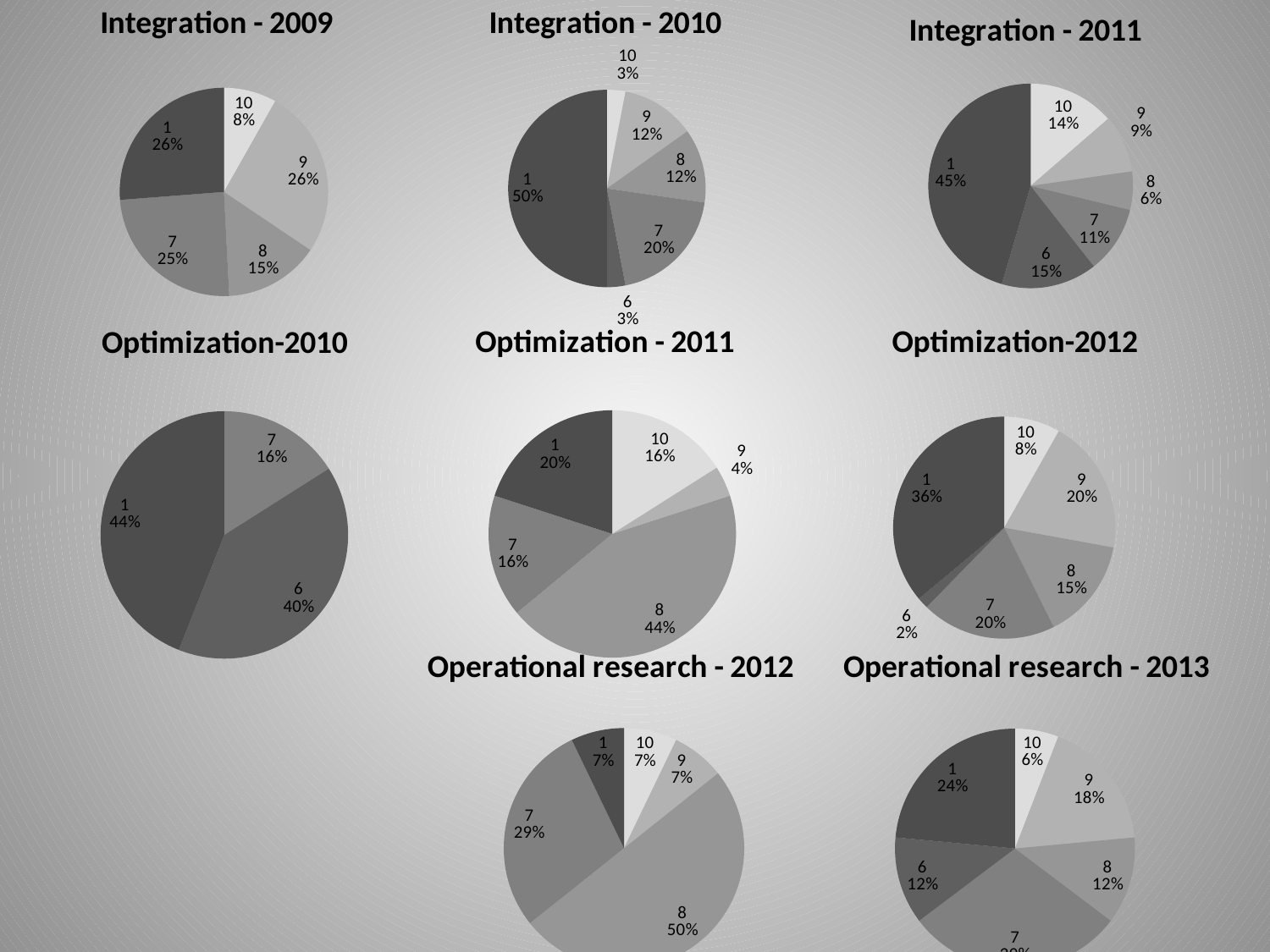
How many slices does the Optimization-2010 chart have? 3 In the Integration - 2010 chart, what share does category 1 have? 50% In the Integration - 2011 chart, what percentage is shown for category 6? 15% How many slices does the Integration - 2011 chart have? 6 In the Integration - 2009 chart, what is the combined share of categories 7 and 8? 40% In the Optimization-2010 chart, which category has the largest slice? 1 How many pie charts are shown on the slide? 8 In the Operational research - 2013 chart, what percentage is shown for category 9? 18% What type of chart is Integration - 2009? Pie chart In the Optimization - 2011 chart, which category has the smallest slice? 9 In the Operational research - 2012 chart, which is larger, the slice for category 8 or the slice for category 7? 8 In the Optimization-2012 chart, what is the difference in percentage points between category 1 and category 10? 28